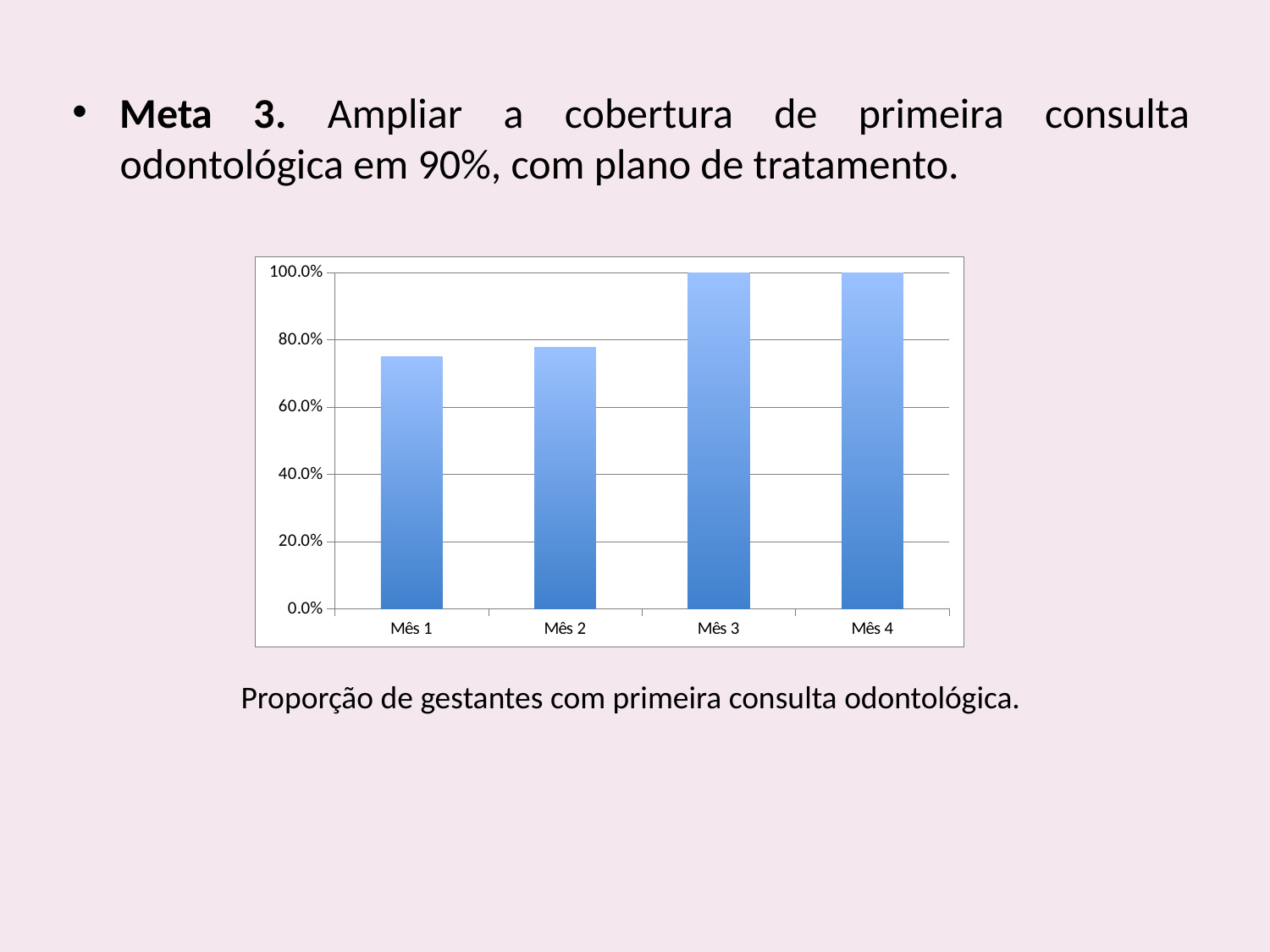
Which is larger, the value for Mês 2 or the value for Mês 3? Mês 3 What is the highest value shown on the chart's y axis? 100.0% Is the value for Mês 1 greater or less than 80.0%? less What is the caption written below the chart? Proporção de gestantes com primeira consulta odontológica. How many categories (months) are plotted on the x axis of the chart? 4 Is the value for Mês 2 greater or less than 80.0%? less What kind of chart is shown on the slide? bar chart Which month has the lowest value in the chart? Mês 1 Do the values in the chart rise or fall from Mês 1 to Mês 4? rise Is the value for Mês 1 greater or less than 60.0%? greater What is the value for Mês 3 in the chart? 100.0% What is the value for Mês 4 in the chart? 100.0%